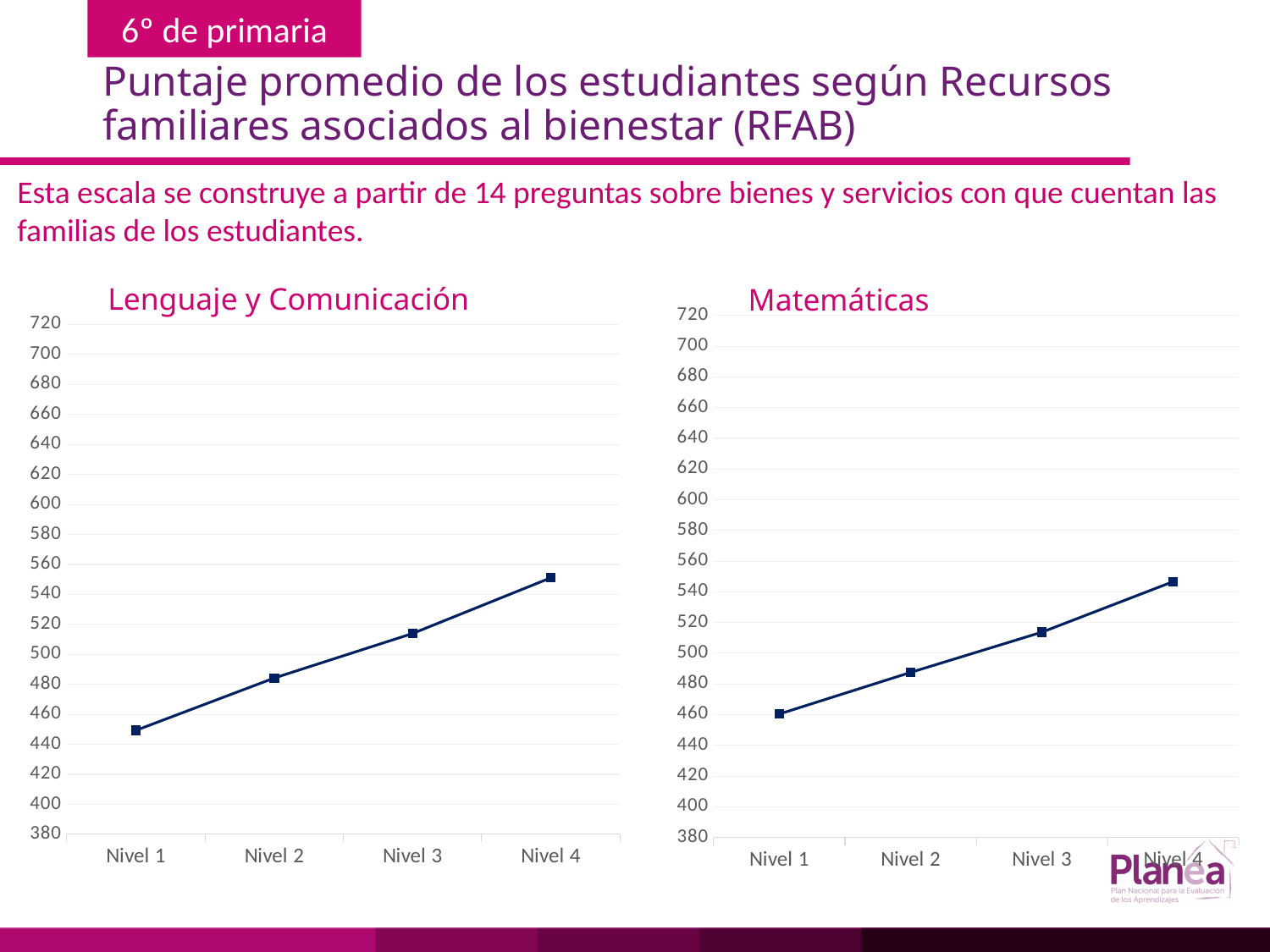
In the Matemáticas chart, is the value for Nivel 2 greater or less than 500? less In the Matemáticas chart, do the values rise or fall from Nivel 1 to Nivel 4? rise In the Lenguaje y Comunicación chart, is the value for Nivel 1 greater or less than 460? less In the Lenguaje y Comunicación chart, is the value for Nivel 4 greater or less than 540? greater In the Lenguaje y Comunicación chart, which is larger, the value for Nivel 2 or the value for Nivel 3? Nivel 3 In the Lenguaje y Comunicación chart, which level has the highest score? Nivel 4 How many categories are shown on the x axis of the Matemáticas chart? 4 In the Matemáticas chart, which level has the lowest score? Nivel 1 What kind of chart is the Lenguaje y Comunicación chart? line chart What is the title of the chart on the right side of the slide? Matemáticas In the Lenguaje y Comunicación chart, do the values rise or fall from Nivel 1 to Nivel 4? rise